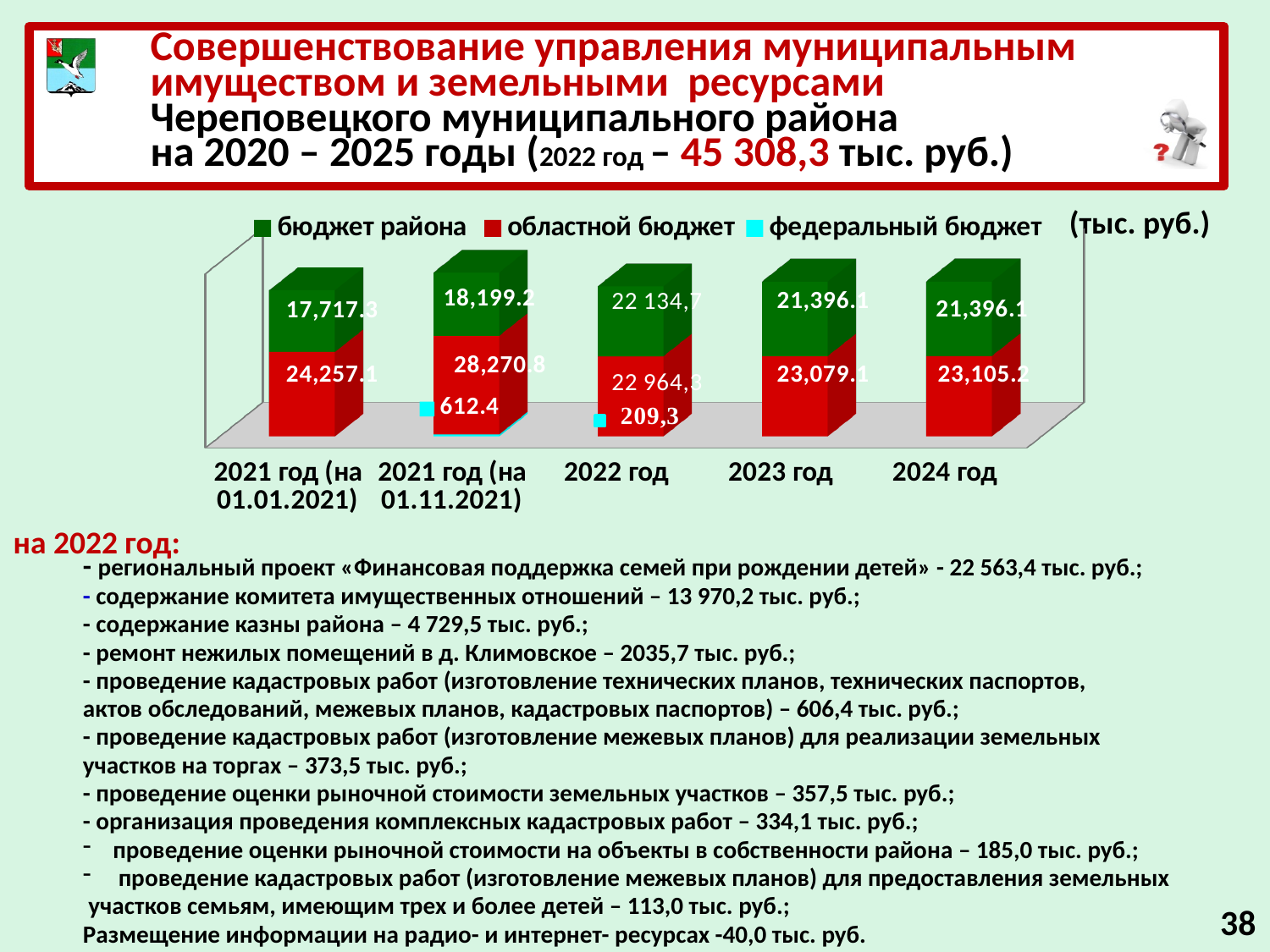
What is the total of the stacked bar for 2022 год? 45 308,3 What is the value of областной бюджет for 2024 год? 23,105.2 What unit is indicated next to the chart legend? тыс. руб. What is the value of областной бюджет for 2022 год? 22 964,3 What is the value of федеральный бюджет for 2021 год (на 01.11.2021)? 612.4 What kind of chart is shown on the slide? Stacked bar chart In which category is бюджет района the lowest? 2021 год (на 01.01.2021) How many categories are shown along the x axis of the chart? 5 In which category is областной бюджет the highest? 2021 год (на 01.11.2021) What is the value of бюджет района for 2021 год (на 01.11.2021)? 18,199.2 Which is larger: федеральный бюджет for 2021 год (на 01.11.2021) or for 2022 год? 2021 год (на 01.11.2021) How many series does the chart legend list? 3